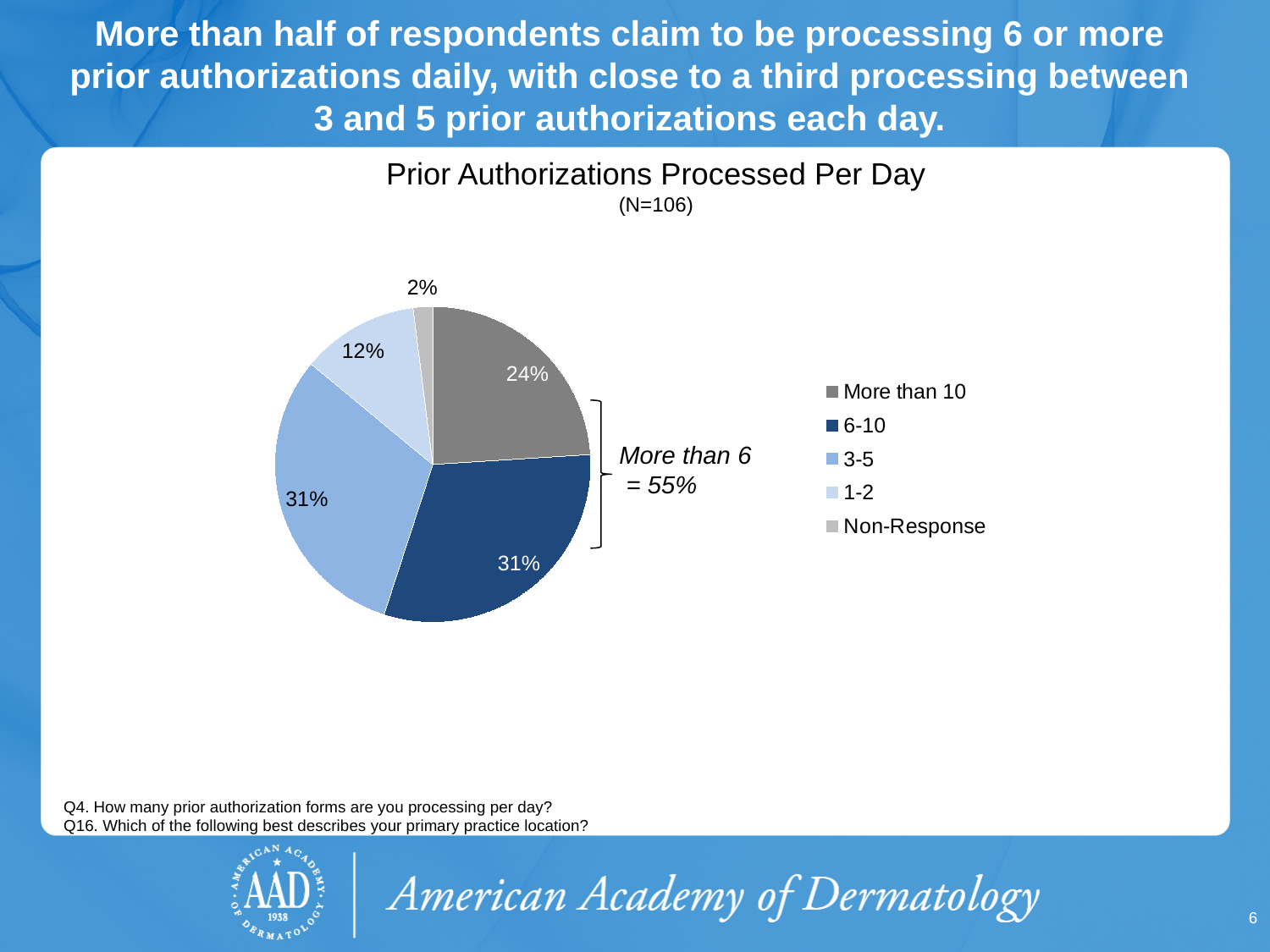
What percentage of respondents process more than 10 prior authorizations per day? 24% How many categories does the legend list? 5 What percentage of respondents process 1-2 prior authorizations per day? 12% What is the difference between the share for 3-5 and the share for 1-2? 19% What is the sample size (N) shown under the chart title? N=106 Which is larger, the share for More than 10 or the share for 1-2? More than 10 Which category has the smallest slice of the pie? Non-Response What is the combined share of respondents processing more than 6 prior authorizations per day, as annotated on the chart? 55% What is the difference between the share for 6-10 and the share for More than 10? 7% What share of the pie is labelled for the 6-10 category? 31% What percentage is shown for Non-Response? 2% What kind of chart is shown on the slide? Pie chart